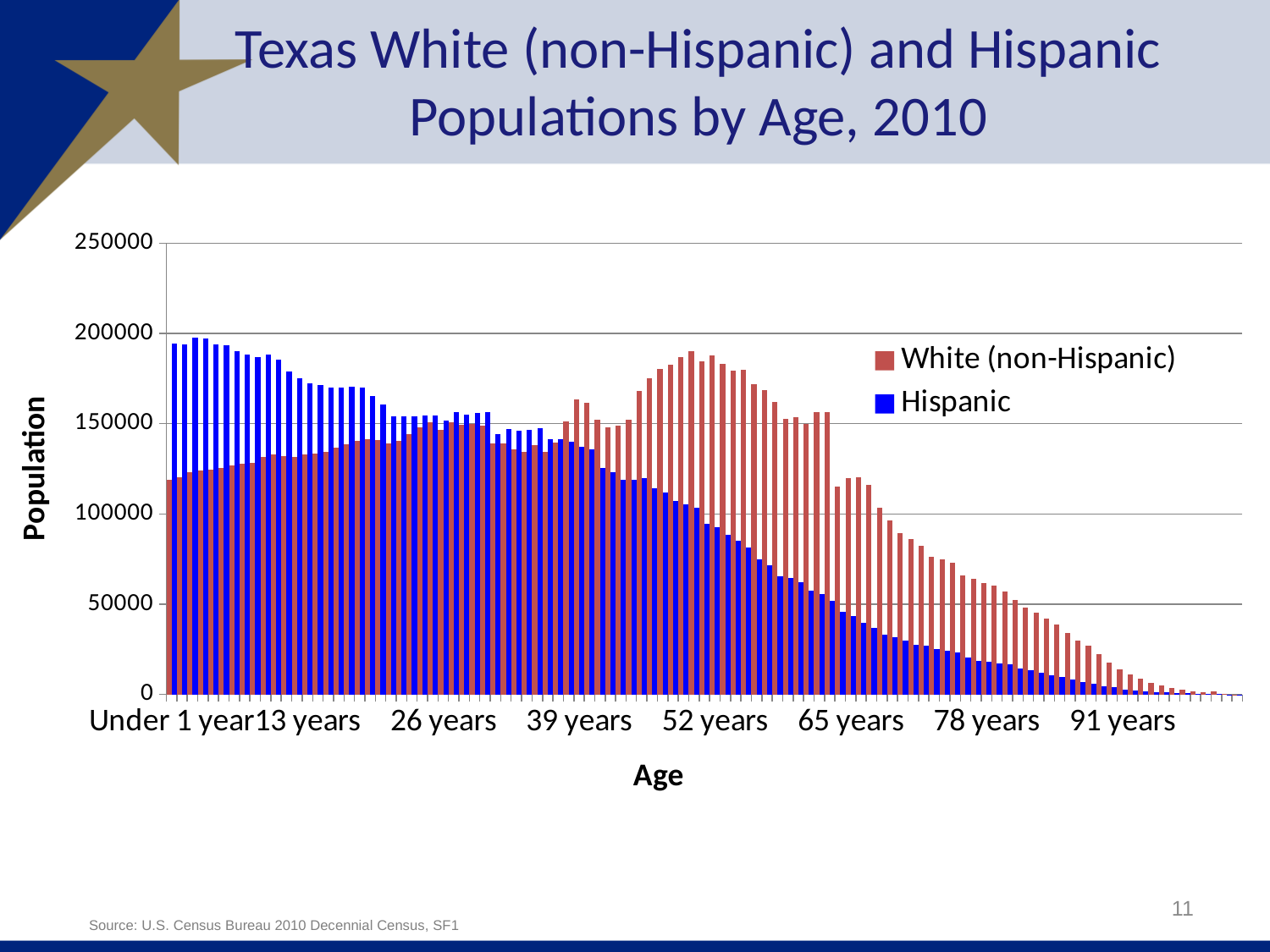
What is the label on the vertical axis? Population What are the two series named in the legend? White (non-Hispanic) and Hispanic Do the Hispanic values generally rise or fall from 26 years to 91 years along the x axis? fall At Under 1 year, which series has the larger value, White (non-Hispanic) or Hispanic? Hispanic At 52 years, which series has the larger value, White (non-Hispanic) or Hispanic? White (non-Hispanic) What kind of chart is shown on the slide? bar chart Is the White (non-Hispanic) value for 52 years greater or less than 150000? greater Is the White (non-Hispanic) value for Under 1 year greater or less than 150000? less Is the Hispanic value for 78 years greater or less than 50000? less How many series does the legend list? 2